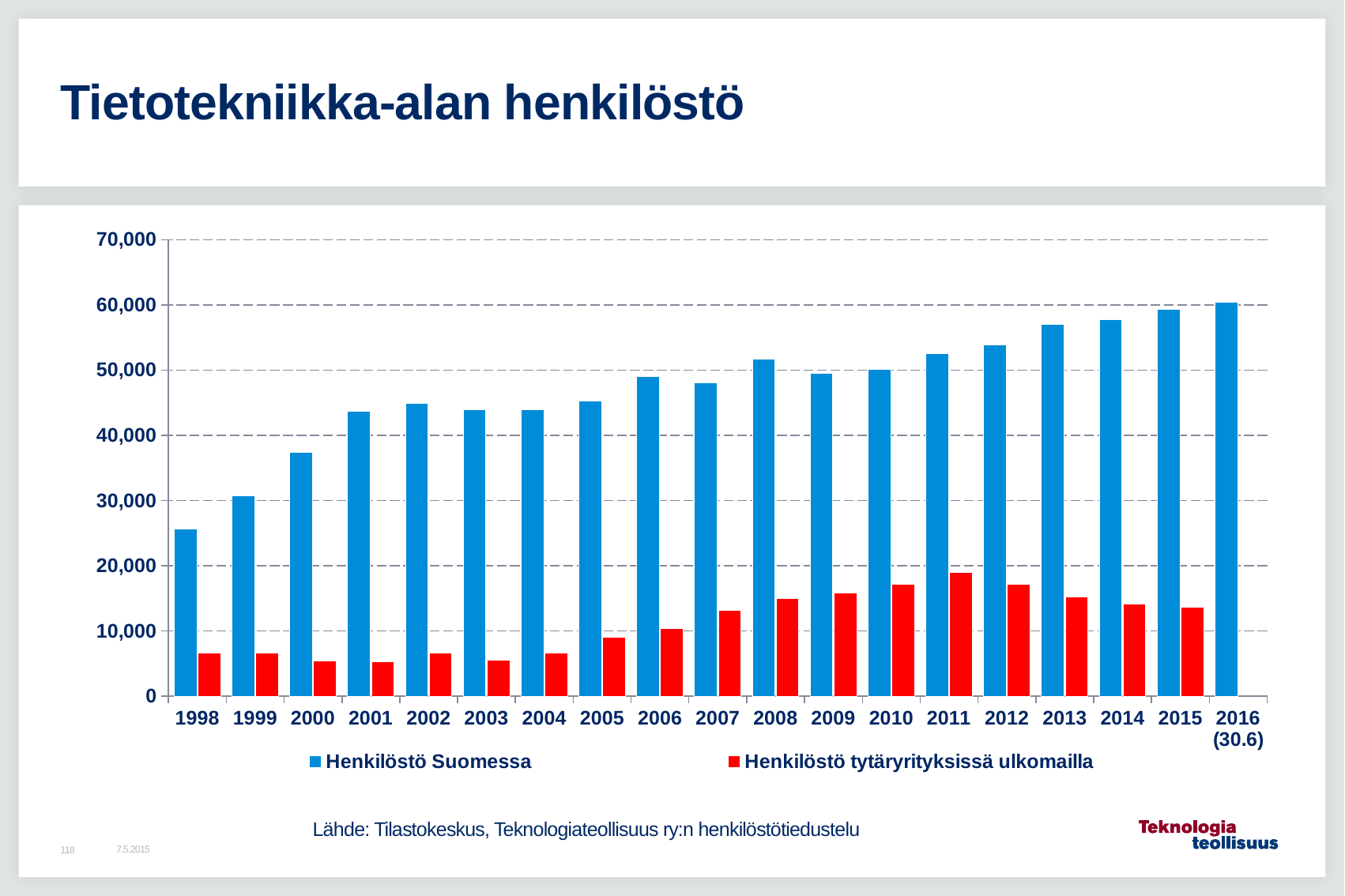
Which is larger for Henkilöstö Suomessa: the value in 2007 or in 2008? 2008 Which year has the highest value for Henkilöstö tytäryrityksissä ulkomailla? 2011 Is the value for Henkilöstö tytäryrityksissä ulkomailla in 2011 greater or less than 20,000? less Which year has the lowest value for Henkilöstö Suomessa? 1998 Is the value for Henkilöstö Suomessa in 1998 greater or less than 30,000? less Which year has the highest value for Henkilöstö Suomessa? 2016 (30.6) How many series does the legend list? 2 Does the value for Henkilöstö Suomessa generally rise or fall from 1998 to 2016? rise How many years (categories) are shown on the x axis? 19 Is the value for Henkilöstö Suomessa in 2013 greater or less than 50,000? greater What kind of chart is shown on the slide? bar chart